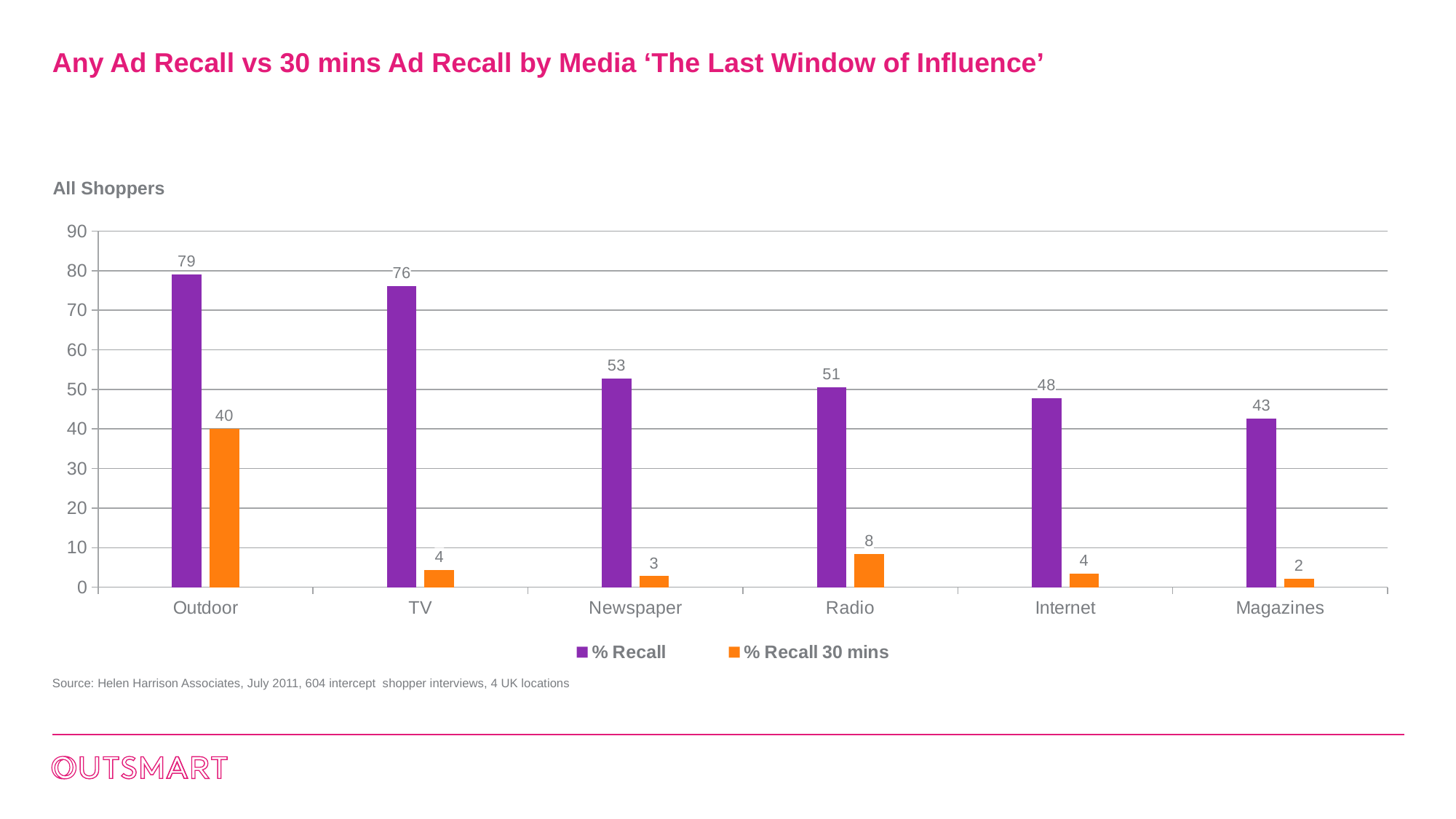
What is the % Recall value for Magazines? 43 How many series does the legend list? 2 Do the % Recall values rise or fall from Outdoor to Magazines along the x axis? Fall What kind of chart is shown on the slide? Bar chart What is the % Recall value for Outdoor? 79 Which media has the highest % Recall 30 mins value? Outdoor Which media has the lowest % Recall value? Magazines How many media categories are shown on the x axis? 6 What is the % Recall 30 mins value for Radio? 8 What is the difference between the % Recall and % Recall 30 mins values for TV? 72 Which is larger: the % Recall value for Newspaper or for Internet? Newspaper What colour are the % Recall 30 mins bars? Orange